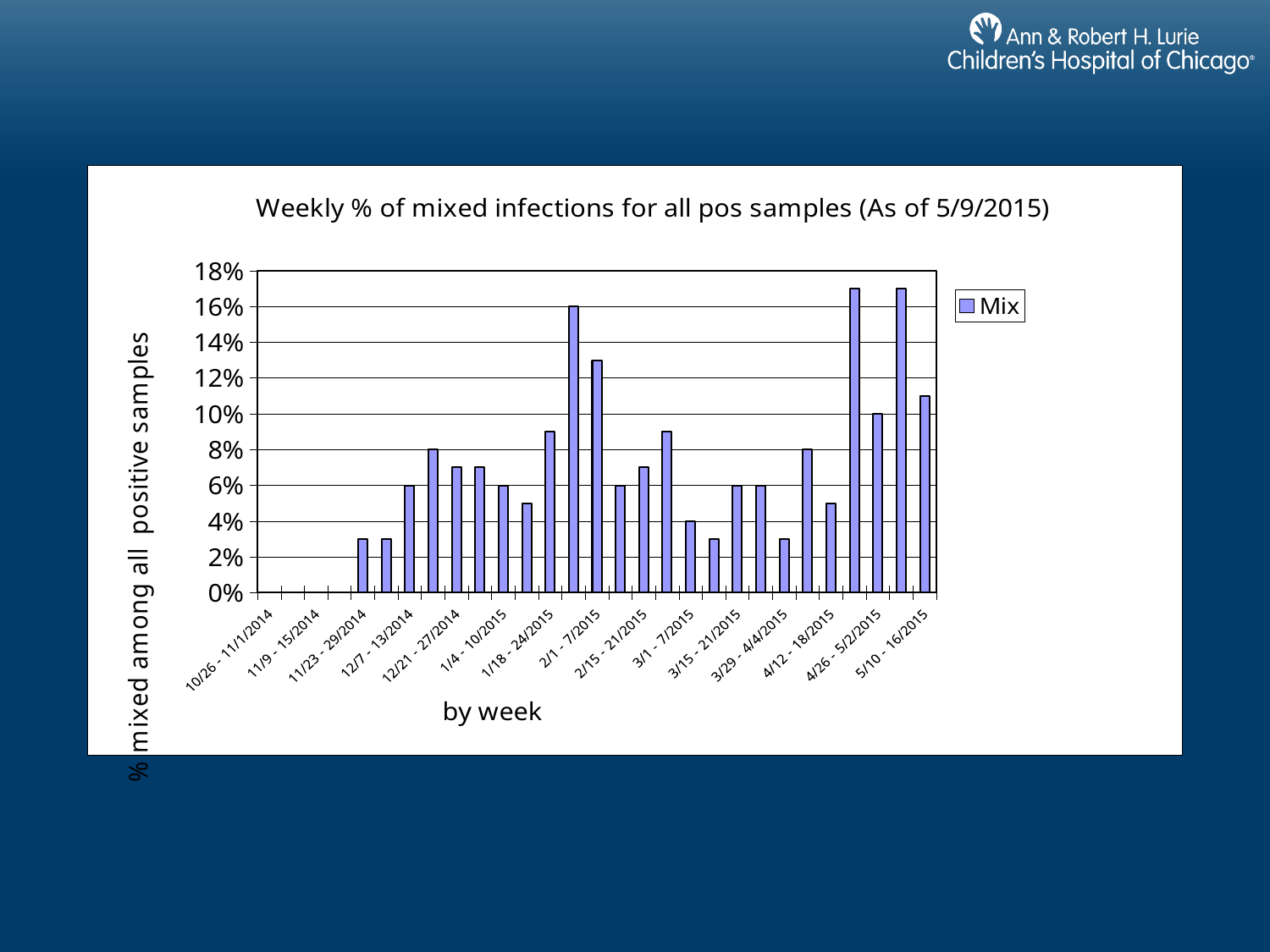
What is the value for the week 3/1 - 7/2015? 4% Is the value for the week 4/12 - 18/2015 greater or less than 6%? less What is the value for the week 12/7 - 13/2014? 6% How many series does the legend list? 1 Is the tallest bar in the chart greater or less than 16%? greater What is the value for the week 4/26 - 5/2/2015? 10% What is the title of the chart? Weekly % of mixed infections for all pos samples (As of 5/9/2015) What is the name of the series shown in the legend? Mix What kind of chart is shown on the slide? bar chart Is the value for the week 2/1 - 7/2015 greater or less than 12%? greater Which is larger, the value for the week 2/1 - 7/2015 or the week 2/15 - 21/2015? 2/1 - 7/2015